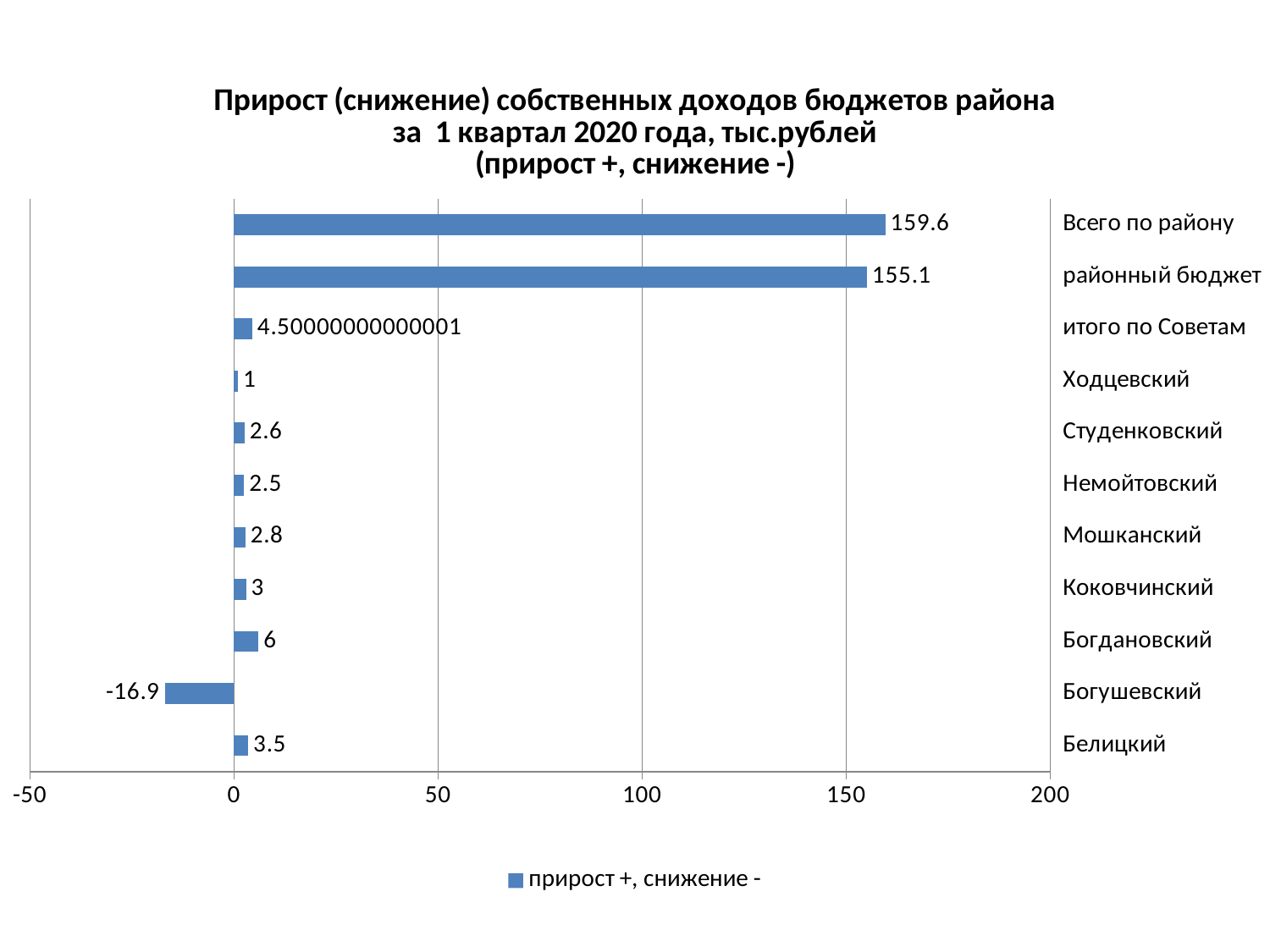
What kind of chart is shown on the slide? Bar chart Which category has the lowest value? Богушевский Is the value for районный бюджет greater or less than 150? greater What is the value for районный бюджет? 155.1 How many categories are shown in the chart? 11 What is the difference between the values for Всего по району and районный бюджет? 4.5 Which is larger, the value for Богдановский or the value for Белицкий? Богдановский Which category has the highest value? Всего по району What is the value for Всего по району? 159.6 What is the value for Богдановский? 6 How many series does the legend list? 1 What is the value for Богушевский? -16.9